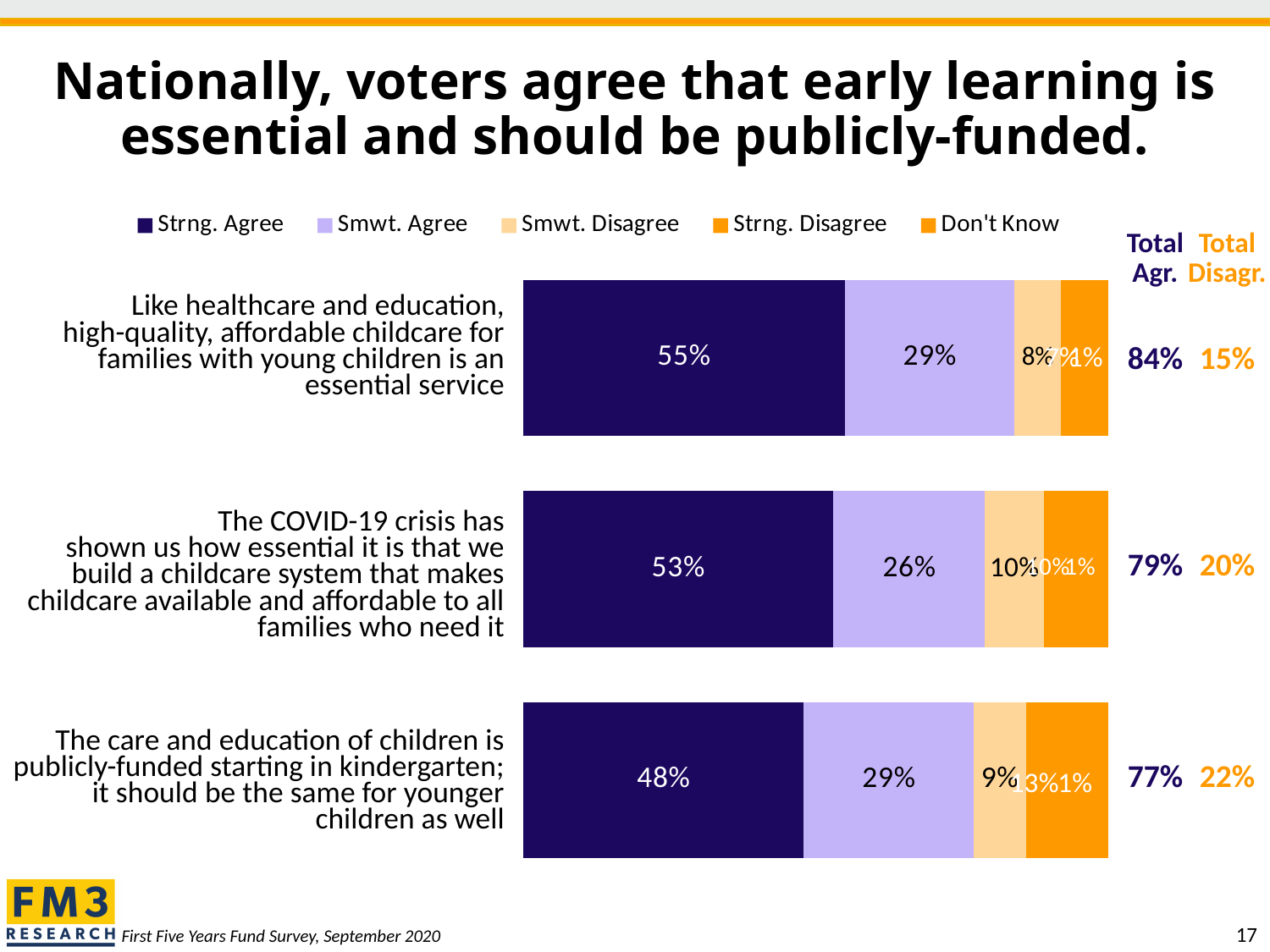
What percentage strongly agree that care and education of younger children should be publicly funded like kindergarten? 48% What kind of chart is shown on the slide? stacked bar chart How many statements (bars) are shown in the chart? 3 What is the Total Agree figure for the statement that the COVID-19 crisis has shown how essential a childcare system is? 79% What percentage strongly agree that high-quality, affordable childcare for families with young children is an essential service? 55% Which colour represents Strongly Agree in the chart? dark navy/purple Which statement has the highest Strongly Agree percentage? Like healthcare and education, high-quality, affordable childcare for families with young children is an essential service What is the Total Disagree figure for the statement that care and education of younger children should be publicly funded like kindergarten? 22% What is the difference between the Strongly Agree percentages for the childcare-as-essential-service statement and the publicly-funded statement? 7 percentage points How many series does the legend list? 5 Which statement has the lowest Total Agree figure? The care and education of children is publicly-funded starting in kindergarten; it should be the same for younger children as well What percentage somewhat agree that the COVID-19 crisis has shown how essential it is to build a childcare system available and affordable to all families? 26%